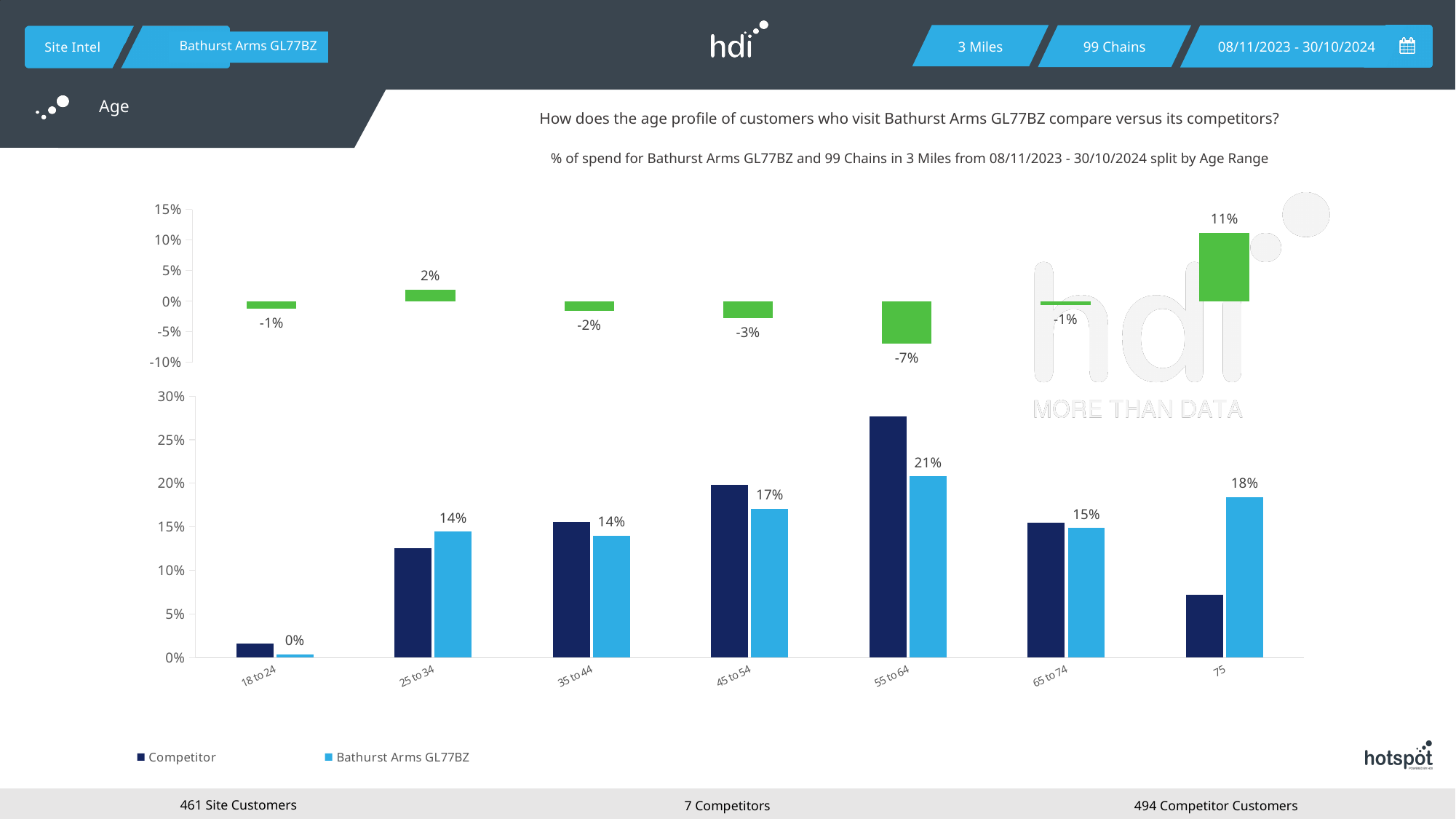
In the top chart, which age range has the lowest value? 55 to 64 In the bottom chart, is the Competitor value for 55 to 64 greater or less than 25%? greater In the bottom chart, for the 75 age range, which is larger: Competitor or Bathurst Arms GL77BZ? Bathurst Arms GL77BZ In the bottom chart, what is the value for Bathurst Arms GL77BZ in the 55 to 64 age range? 21% In the top chart, what is the value shown for the 55 to 64 age range? -7% In the bottom chart, what is the difference between the Bathurst Arms GL77BZ values for 55 to 64 and 45 to 54? 4% In the bottom chart, is the Competitor value for 75 greater or less than 10%? less In the bottom chart, what is the value for Bathurst Arms GL77BZ in the 18 to 24 age range? 0% In the top chart, what is the value shown for the 75 age range? 11% In the bottom chart, which age range has the highest value for Bathurst Arms GL77BZ? 55 to 64 In the top chart, which age range has the highest value? 75 How many series does the legend of the bottom chart list? 2